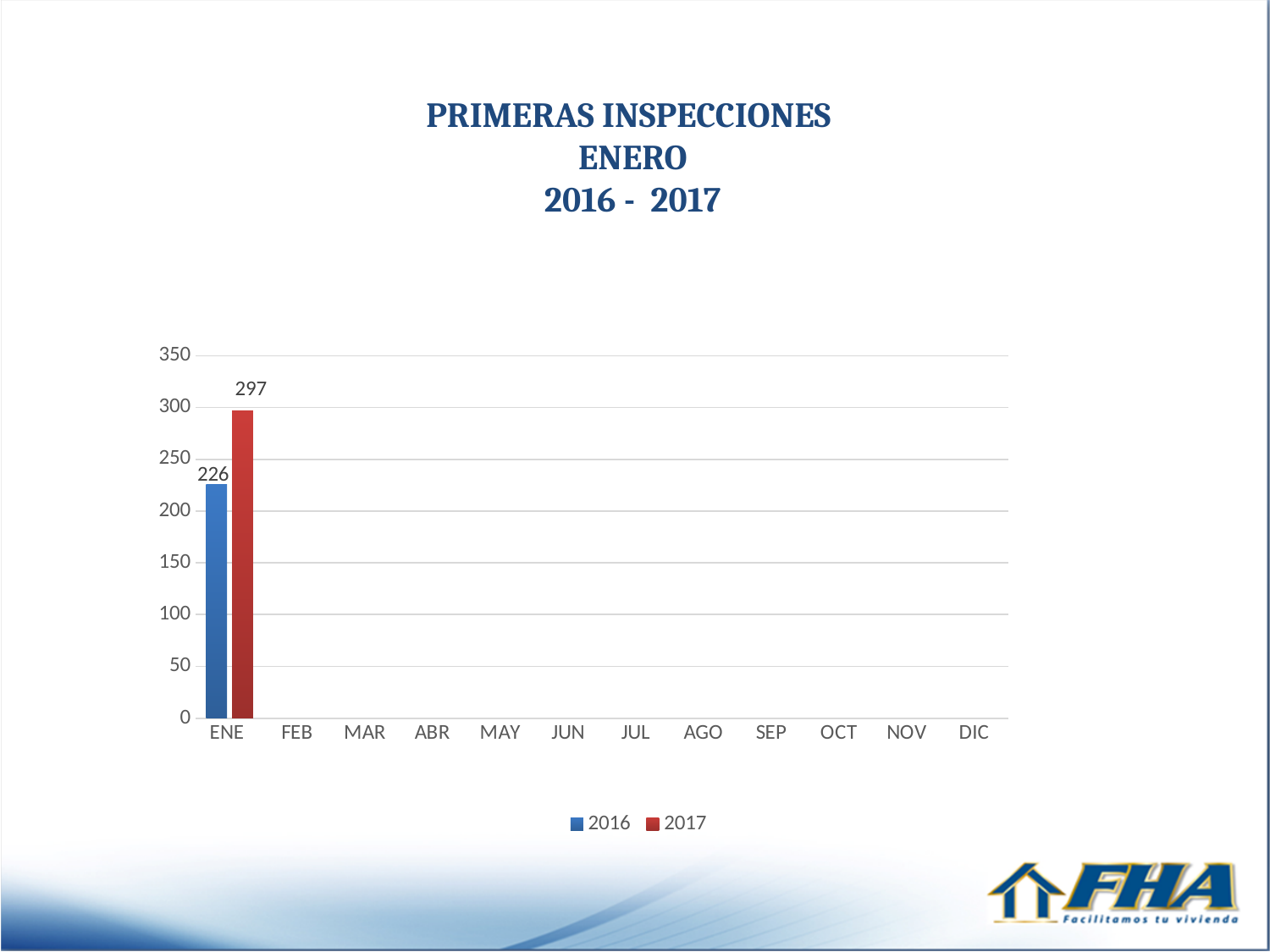
What kind of chart is shown on the slide? bar chart Which series has the higher value in ENE, 2016 or 2017? 2017 Which month is the only one with plotted bars? ENE What is the title of the chart? PRIMERAS INSPECCIONES ENERO 2016 - 2017 What is the value for 2017 in ENE? 297 What is the difference between the 2017 and 2016 values in ENE? 71 How many series does the legend list? 2 What is the value for 2016 in ENE? 226 How many month categories are shown on the x axis? 12 Is the value for 2017 in ENE greater or less than 250? greater Is the value for 2016 in ENE greater or less than 250? less Which colour represents the 2017 series? red